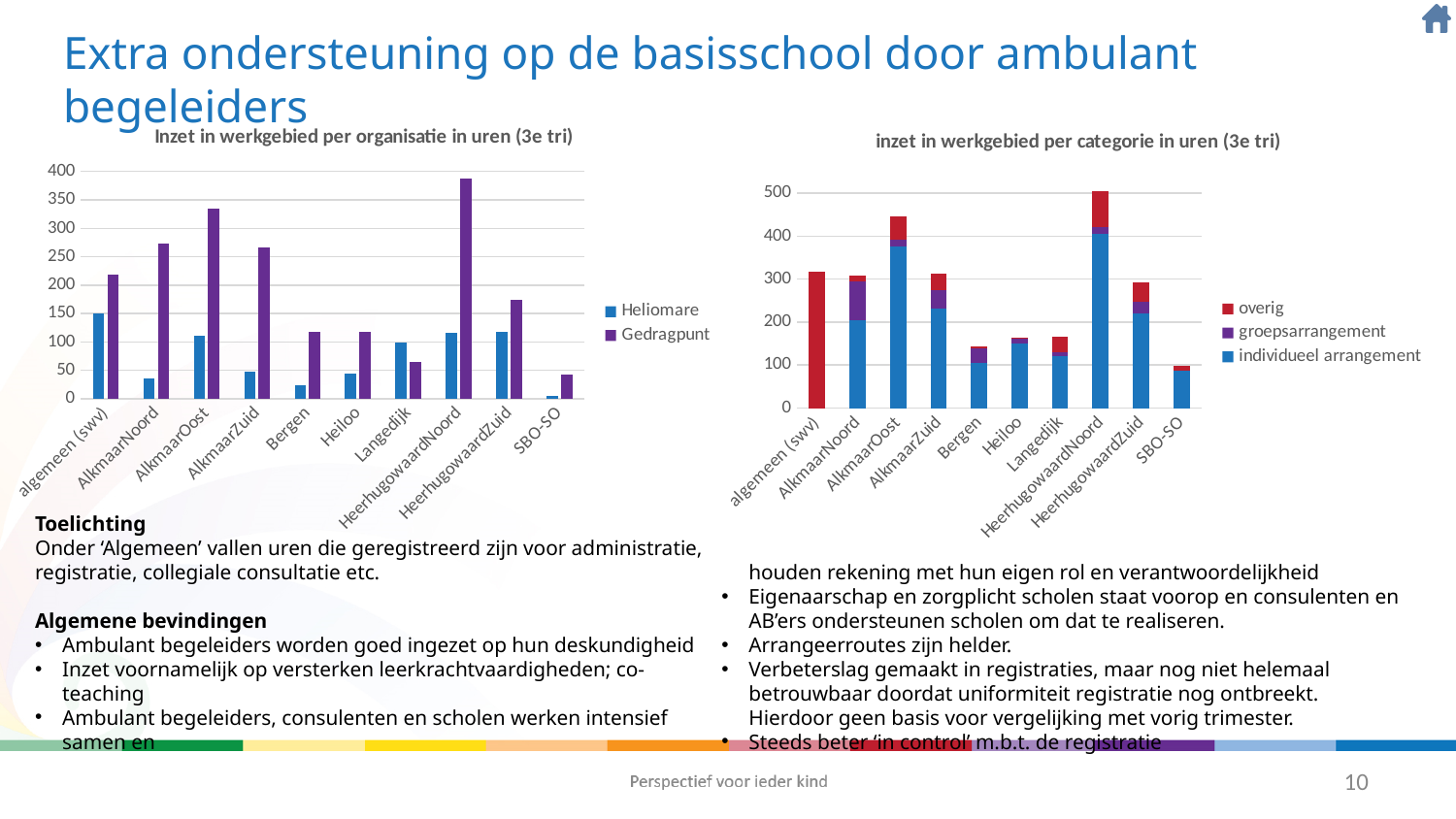
In the left chart 'Inzet in werkgebied per organisatie in uren (3e tri)', which category has the highest Gedragpunt value? HeerhugowaardNoord In the right chart 'inzet in werkgebied per categorie in uren (3e tri)', which category has the tallest stacked bar? HeerhugowaardNoord In the left chart 'Inzet in werkgebied per organisatie in uren (3e tri)', which category has the lowest Heliomare value? SBO-SO In the right chart 'inzet in werkgebied per categorie in uren (3e tri)', is the total for AlkmaarOost greater or less than 400? greater In the left chart 'Inzet in werkgebied per organisatie in uren (3e tri)', how many categories are shown on the x axis? 10 In the left chart 'Inzet in werkgebied per organisatie in uren (3e tri)', is the Gedragpunt value for HeerhugowaardNoord greater or less than 350? greater In the left chart 'Inzet in werkgebied per organisatie in uren (3e tri)', for Langedijk, which is larger: Heliomare or Gedragpunt? Heliomare In the right chart 'inzet in werkgebied per categorie in uren (3e tri)', which category has the shortest stacked bar? SBO-SO How many series does the legend of the right chart 'inzet in werkgebied per categorie in uren (3e tri)' list? 3 What kind of chart is the left chart titled 'Inzet in werkgebied per organisatie in uren (3e tri)'? bar chart In the right chart 'inzet in werkgebied per categorie in uren (3e tri)', which series is shown in red according to the legend? overig In the left chart 'Inzet in werkgebied per organisatie in uren (3e tri)', is the Heliomare value for algemeen (swv) greater or less than 100? greater